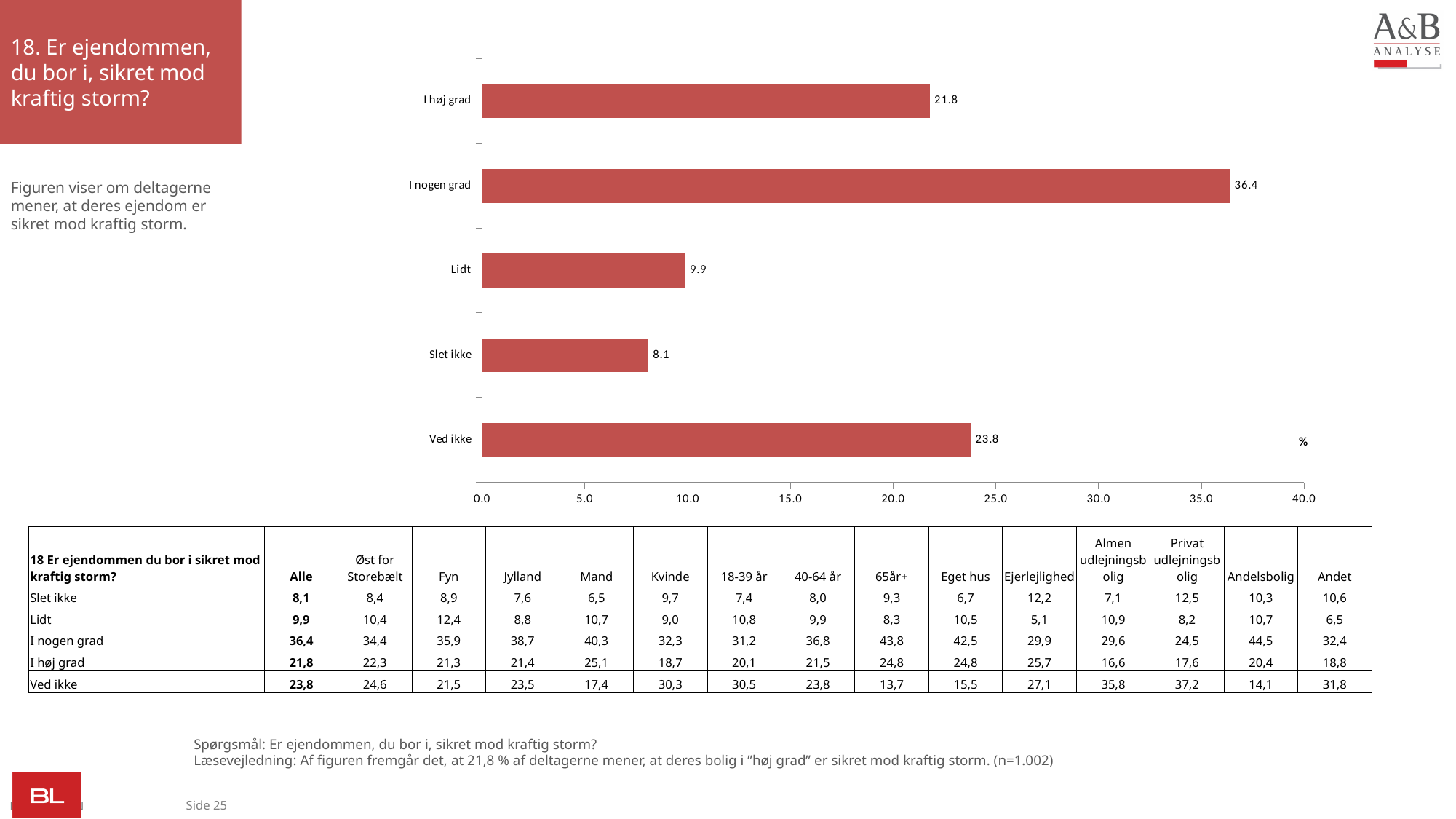
What is the value for "Slet ikke" in the chart? 8.1 What is the difference between the values for "Lidt" and "Slet ikke"? 1.8 What is the difference between the values for "I nogen grad" and "I høj grad"? 14.6 Which category has the lowest value in the chart? Slet ikke What is the value for "I nogen grad" in the chart? 36.4 Is the value for "Lidt" greater or less than 10.0? less How many categories are shown in the chart? 5 Which is larger, the value for "Ved ikke" or the value for "I høj grad"? Ved ikke What kind of chart is shown on the slide? bar chart Which category has the highest value in the chart? I nogen grad What is the value for "Ved ikke" in the chart? 23.8 What is the maximum value shown on the x axis of the chart? 40.0